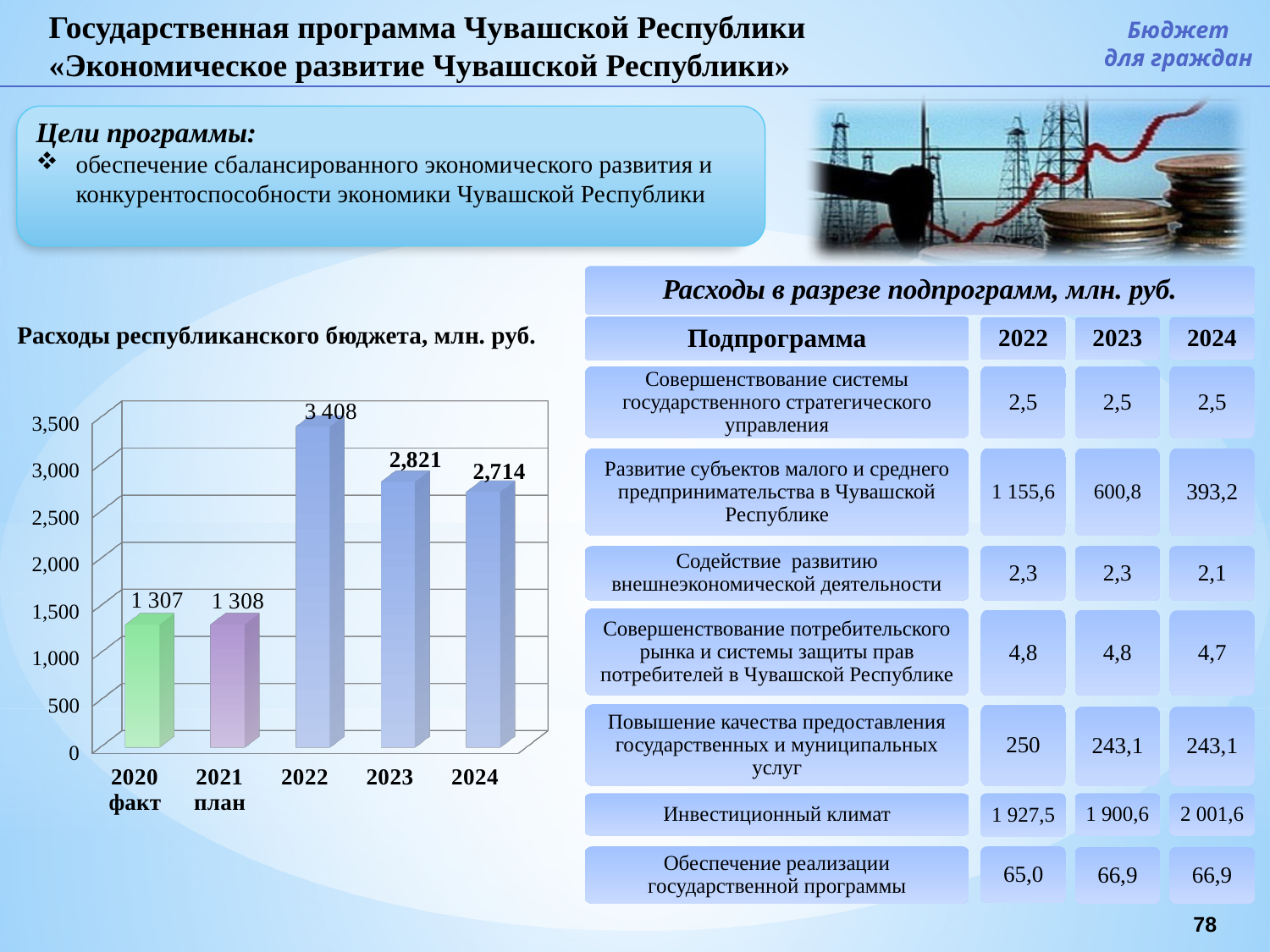
What is the difference between the values for 2022 and 2023? 587 What is the title of the bar chart? Расходы республиканского бюджета, млн. руб. What is the value for 2024 in the chart? 2,714 Is the value for 2022 greater or less than 3,000? greater What is the difference between the values for 2023 and 2024? 107 What is the value for 2021 план in the chart? 1 308 Which is larger, the value for 2023 or the value for 2024? 2023 What type of chart is shown on the slide? bar chart How many bars are shown in the chart? 5 What is the value for 2020 факт in the chart? 1 307 What is the value for 2022 in the chart 'Расходы республиканского бюджета, млн. руб.'? 3 408 Which year has the highest value in the chart? 2022